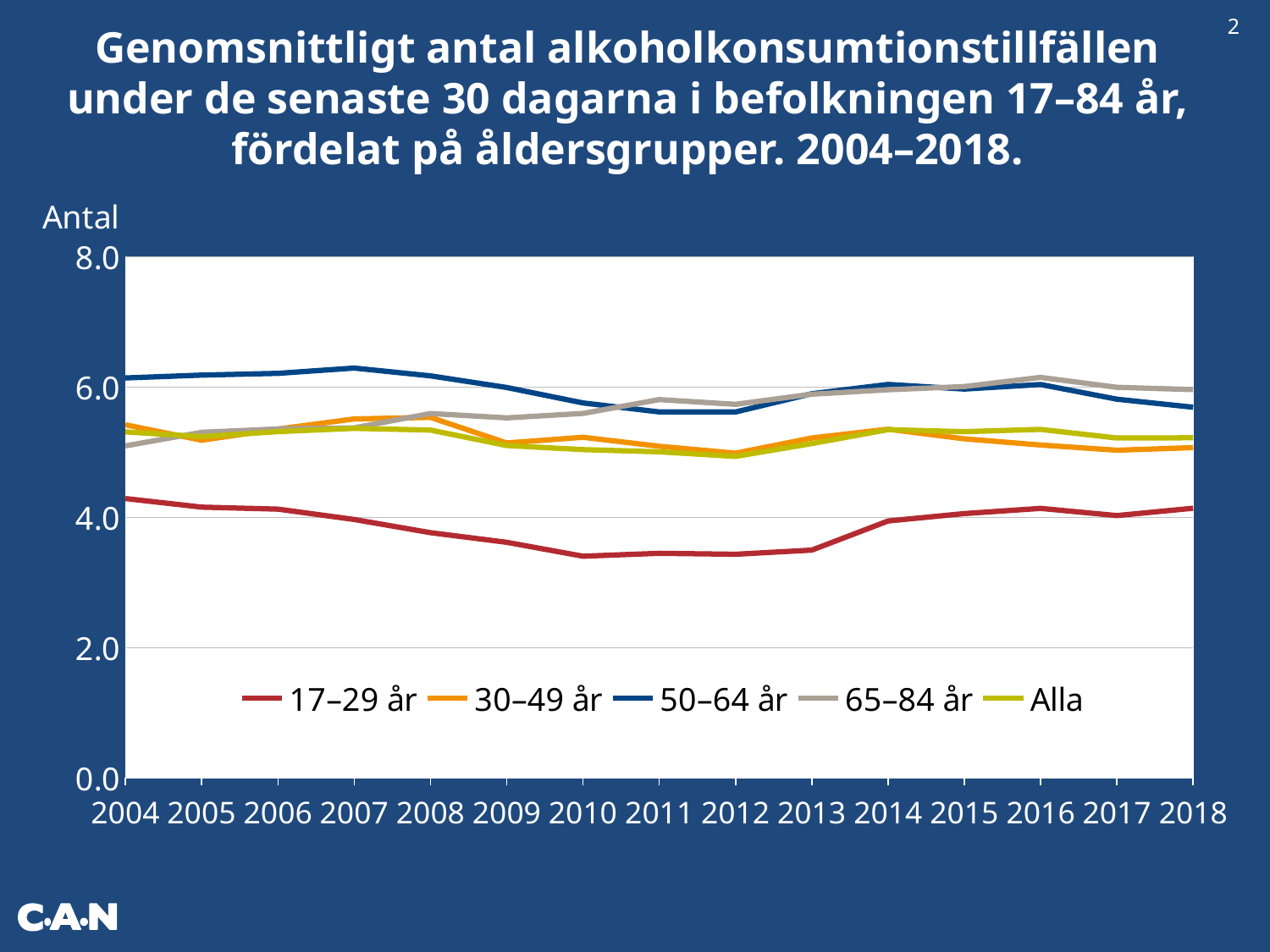
How many series does the legend list? 5 What is the label on the y axis? Antal Which series has the highest value in 2007? 50–64 år What kind of chart is shown on the slide? line chart Is the value for 30–49 år in 2012 greater or less than 6.0? less In 2010, which is higher: 50–64 år or 17–29 år? 50–64 år Is the value for 17–29 år in 2004 greater or less than 4.0? greater How many years are shown along the x axis? 15 Is the value for 50–64 år in 2007 greater or less than 6.0? greater Does the 17–29 år line rise or fall from 2004 to 2010? fall Which series has the lowest values across all years? 17–29 år